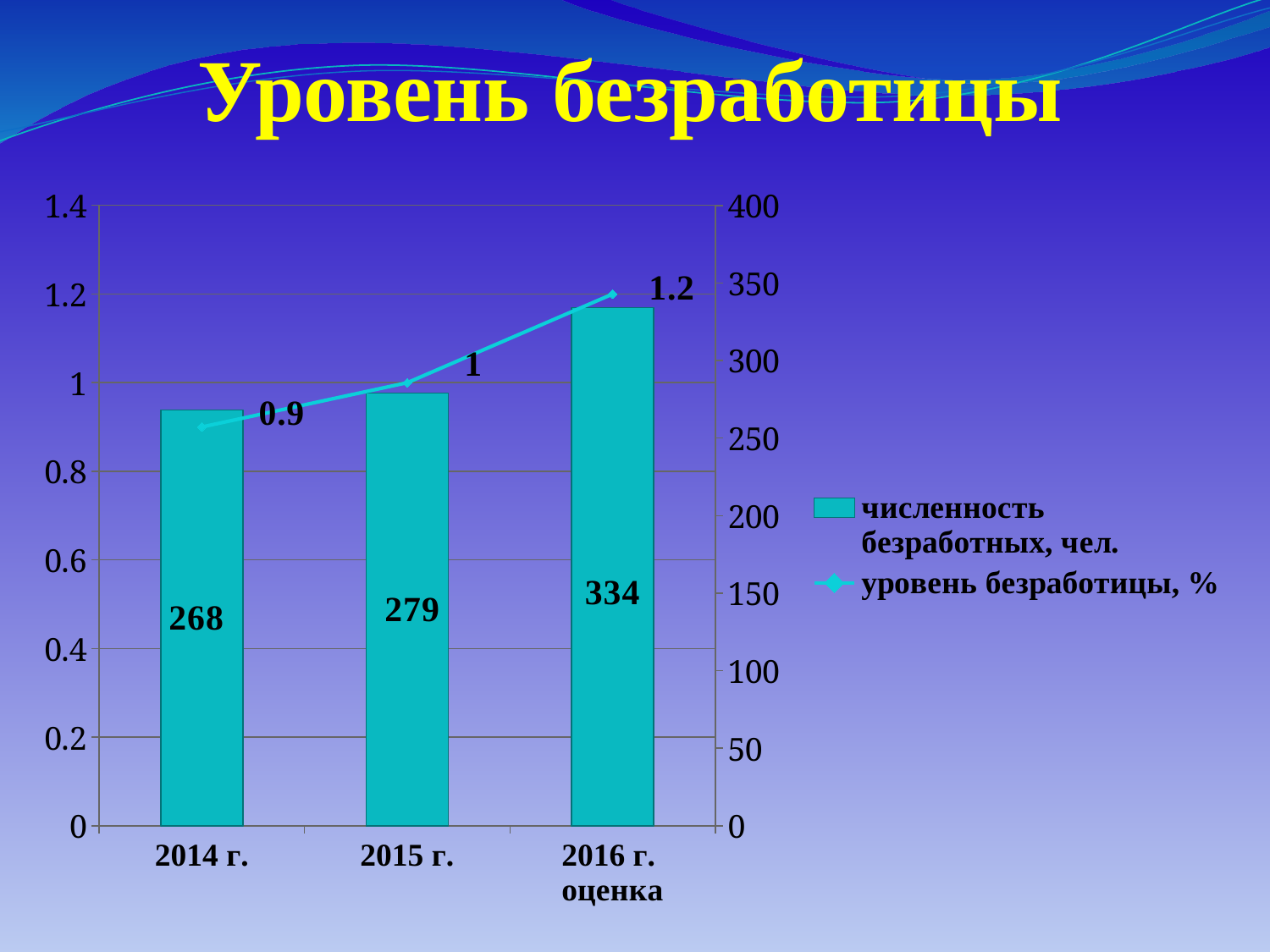
What is the value of численность безработных, чел. for 2014 г.? 268 What is the value of уровень безработицы, % for 2016 г. оценка? 1.2 Which year has the highest численность безработных, чел.? 2016 г. оценка Which year has the lowest уровень безработицы, %? 2014 г. Which is larger, численность безработных, чел. for 2014 г. or for 2015 г.? 2015 г. Does уровень безработицы, % rise or fall from 2014 г. to 2016 г. оценка? rise What is the value of уровень безработицы, % for 2015 г.? 1 What is the title of the slide? Уровень безработицы What is the difference in численность безработных, чел. between 2016 г. оценка and 2015 г.? 55 What is the value of численность безработных, чел. for 2016 г. оценка? 334 How many series does the legend list? 2 How many years are shown on the x axis? 3